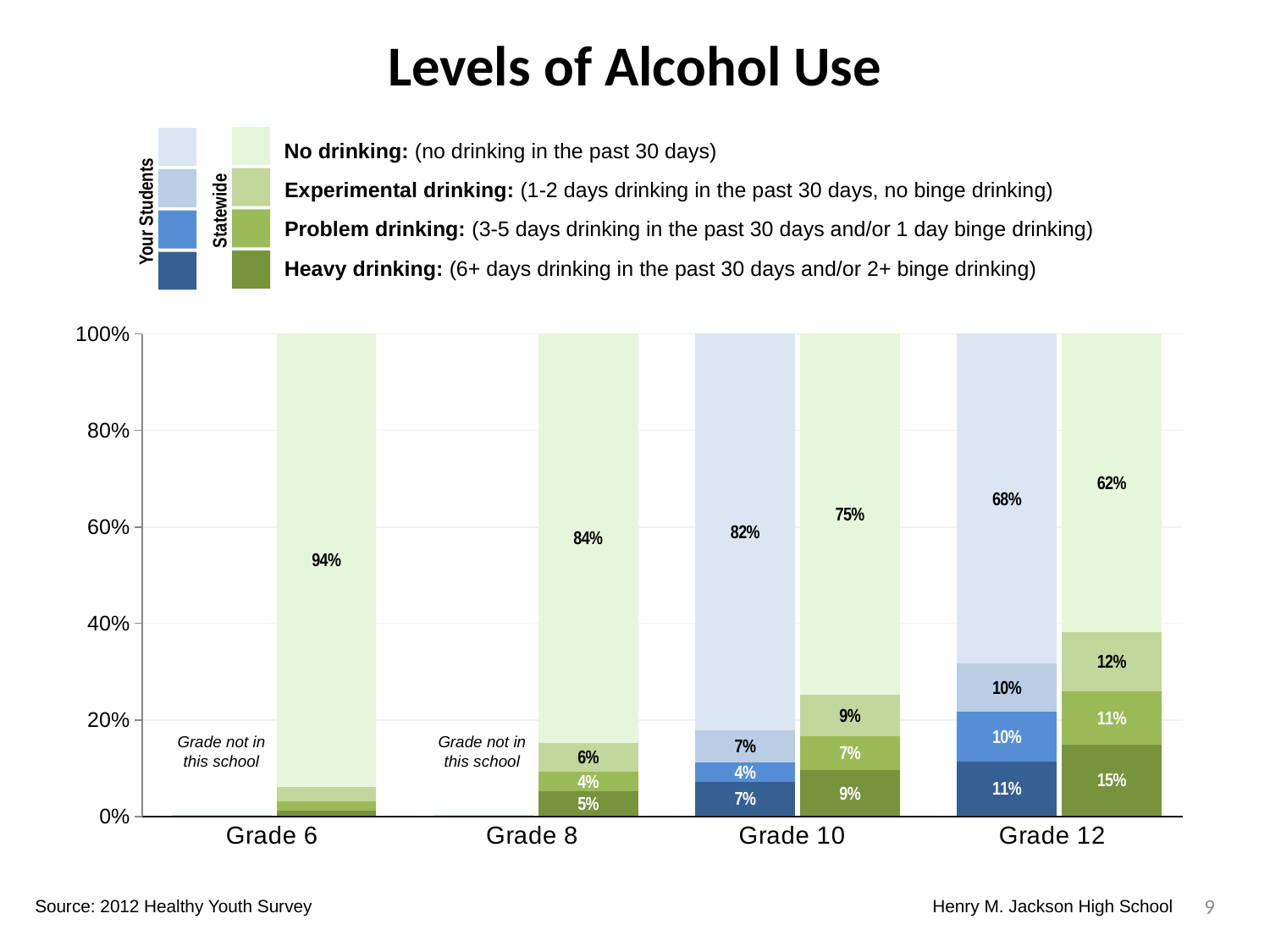
What percentage of Your Students in Grade 10 reported no drinking? 82% Does the statewide no drinking percentage rise or fall from Grade 6 to Grade 12? Falls For Grade 12, how many percentage points higher is the no drinking share for Your Students than Statewide? 6 percentage points What percentage of Grade 6 students statewide reported no drinking? 94% Which grade has the highest statewide heavy drinking percentage? Grade 12 Which grades are marked as not in this school? Grade 6 and Grade 8 For Grade 10 heavy drinking, which is larger: Your Students or Statewide? Statewide What is the statewide experimental drinking percentage for Grade 8? 6% What type of chart is shown on the slide? Stacked bar chart What is the problem drinking percentage for Your Students in Grade 12? 10% What is the statewide heavy drinking percentage for Grade 12? 15% How many grade categories are shown on the x axis? 4